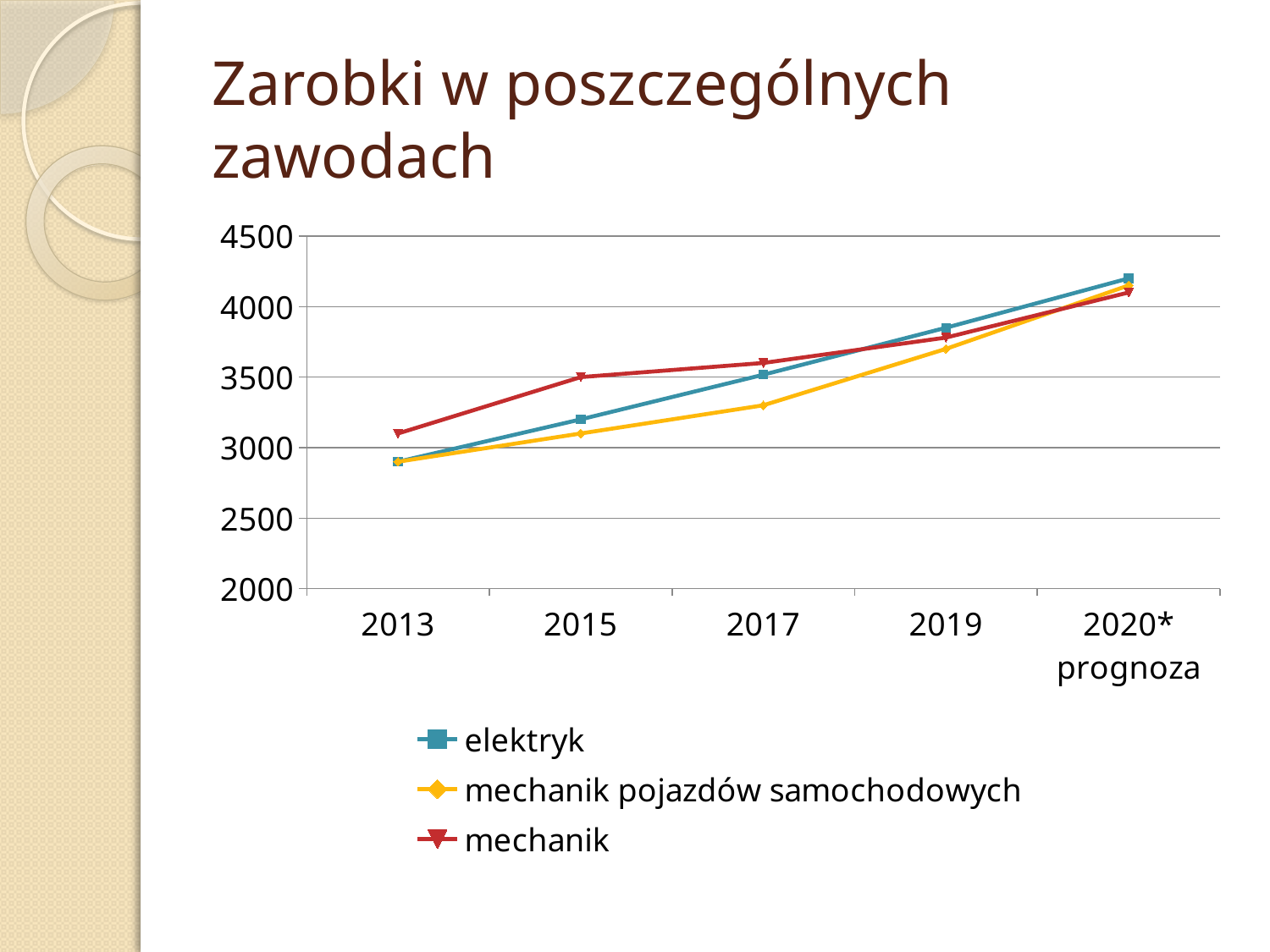
Which series has the lowest value in 2017? mechanik pojazdów samochodowych Is the value for elektryk in 2013 greater or less than 3000? less What kind of chart is shown on the slide? line chart What is the title of the chart? Zarobki w poszczególnych zawodach How many points along the x axis does each line have? 5 Which series has the highest value in 2013? mechanik Is the value for mechanik in 2013 greater or less than 3000? greater Is the value for mechanik pojazdów samochodowych in 2017 greater or less than 3500? less Do the values for elektryk rise or fall from 2013 to 2020* prognoza? rise In 2019, which is larger: the value for elektryk or for mechanik pojazdów samochodowych? elektryk How many series does the legend list? 3